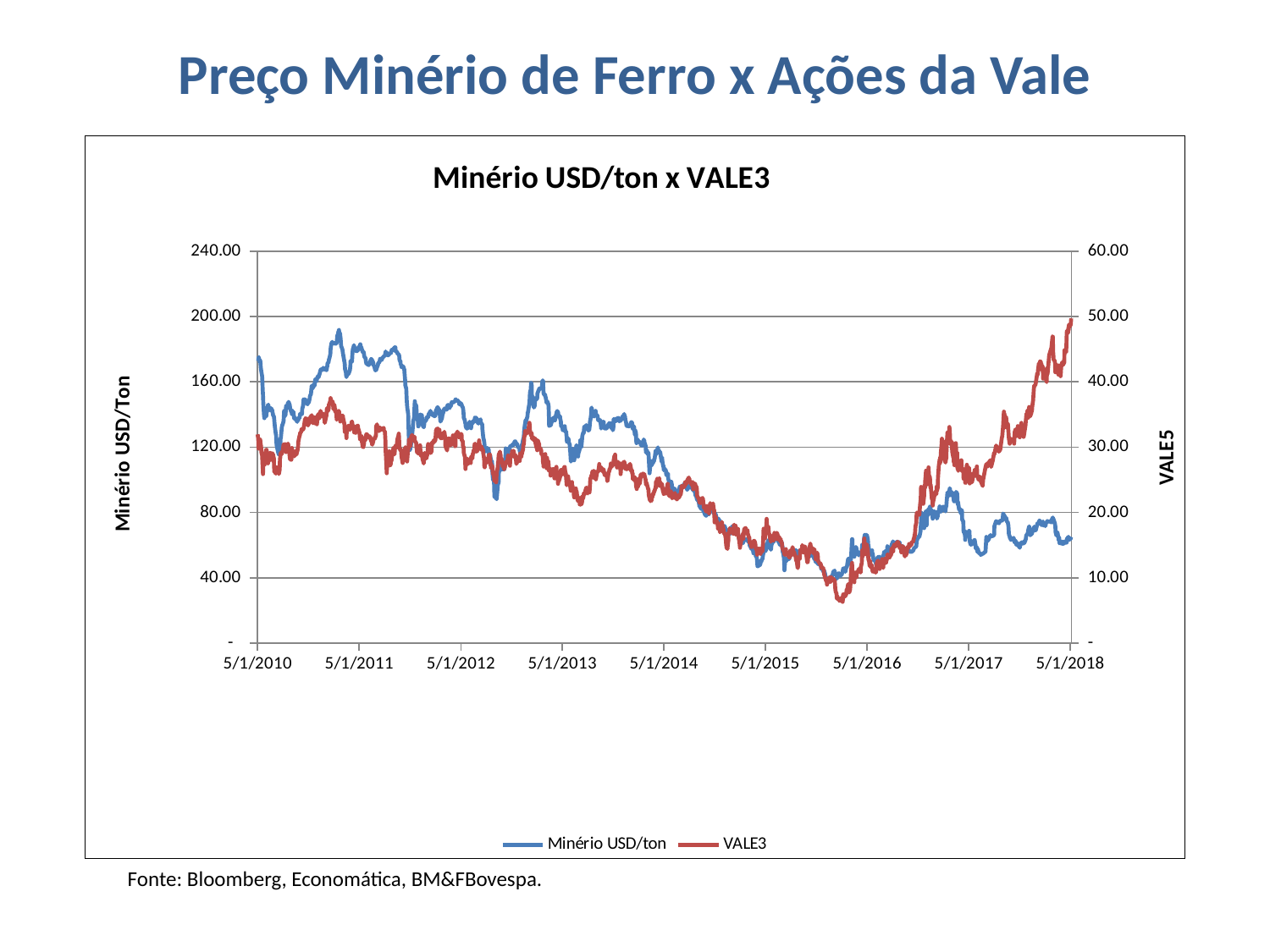
What are the two series named in the legend? Minério USD/ton and VALE3 How many series does the legend list? 2 Is the value of Minério USD/ton at 5/1/2018 greater or less than 80.00? less How many date labels are shown on the x axis? 9 Is the value of VALE3 at 5/1/2017 greater or less than 20.00 on the right axis? greater What kind of chart is shown on the slide? line chart Is the value of VALE3 at 5/1/2018 greater or less than 40.00 on the right axis? greater What is the title of the chart? Minério USD/ton x VALE3 Does the Minério USD/ton series rise or fall between 5/1/2011 and 5/1/2016? fall Does the VALE3 series rise or fall between 5/1/2016 and 5/1/2018? rise